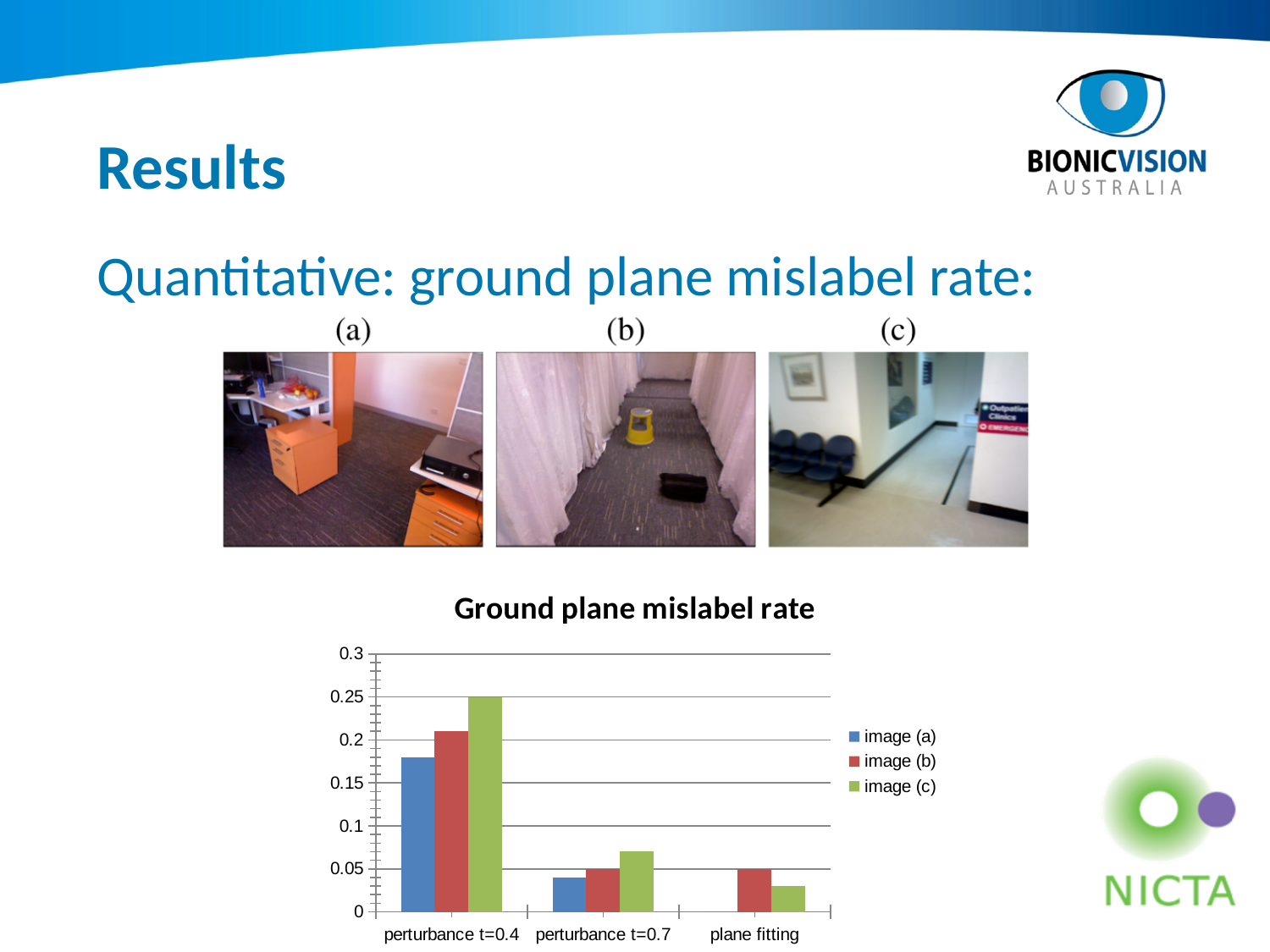
What is the title of the chart? Ground plane mislabel rate For image (c), which category has the highest mislabel rate? perturbance t=0.4 At plane fitting, which is larger: image (b) or image (c)? image (b) At perturbance t=0.4, which is larger: image (a) or image (c)? image (c) Which series has the lowest value at perturbance t=0.4? image (a) How many series does the legend of the chart list? 3 Is the value for image (a) at perturbance t=0.4 greater or less than 0.2? less Is the value for image (c) at perturbance t=0.7 greater or less than 0.1? less Is the value for image (b) at perturbance t=0.4 greater or less than 0.2? greater What are the three legend entries of the chart? image (a), image (b), image (c) How many categories are shown on the x axis of the chart? 3 What kind of chart is shown on the slide? bar chart